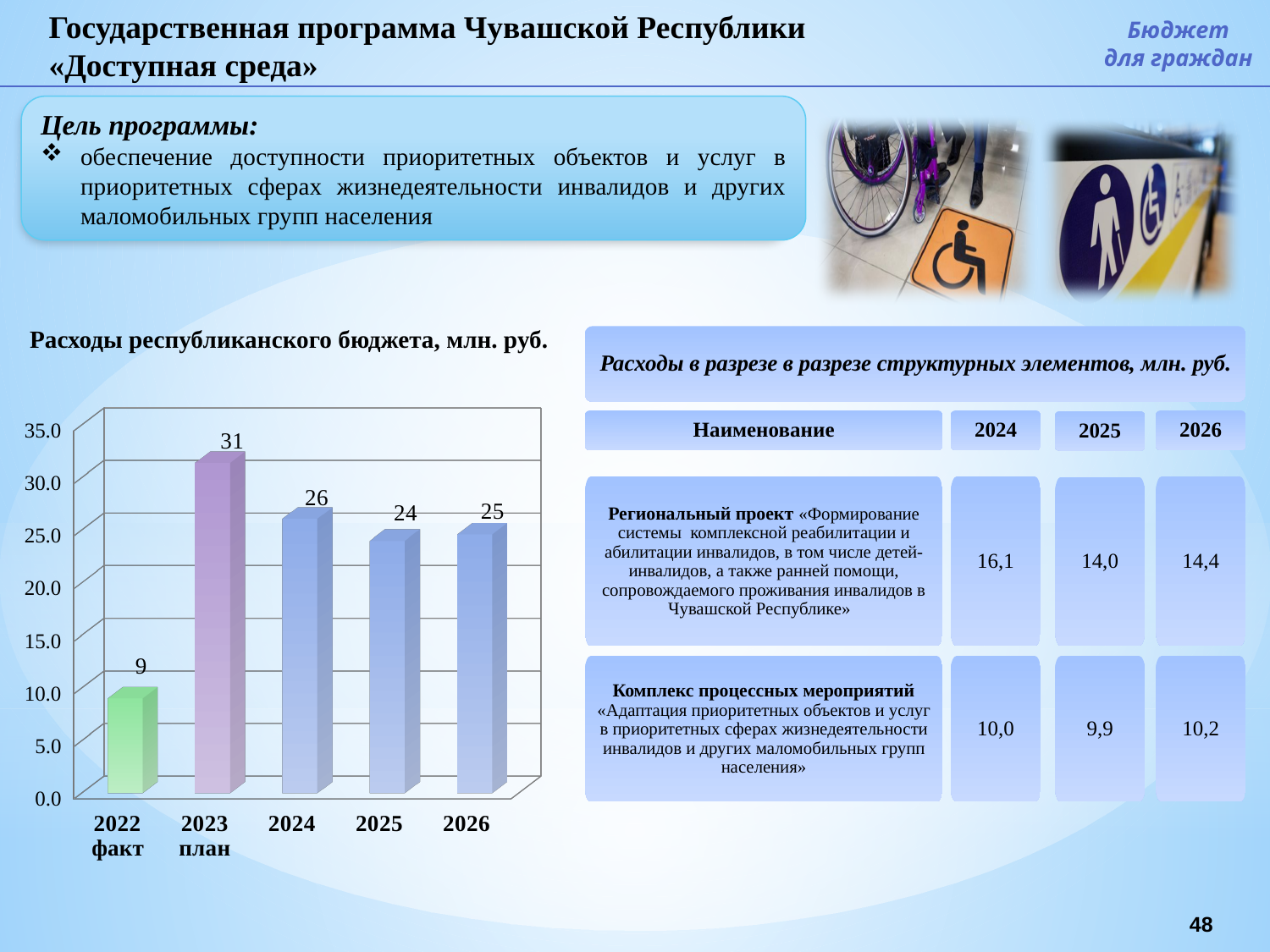
What is the value for 2023 план in the chart 'Расходы республиканского бюджета, млн. руб.'? 31 Is the value for 2026 in the bar chart greater or less than 20.0? greater How many categories are shown on the x axis of the bar chart? 5 What is the value for 2025 in the bar chart? 24 Which is larger in the bar chart, the value for 2024 or the value for 2025? 2024 What is the difference between the values for 2023 план and 2022 факт in the bar chart? 22 What is the value for 2022 факт in the bar chart? 9 What is the title of the chart on the left of the slide? Расходы республиканского бюджета, млн. руб. What kind of chart is used to show 'Расходы республиканского бюджета, млн. руб.'? bar chart Which year has the highest value in the bar chart? 2023 план Which year has the lowest value in the bar chart? 2022 факт What is the difference between the values for 2024 and 2026 in the bar chart? 1